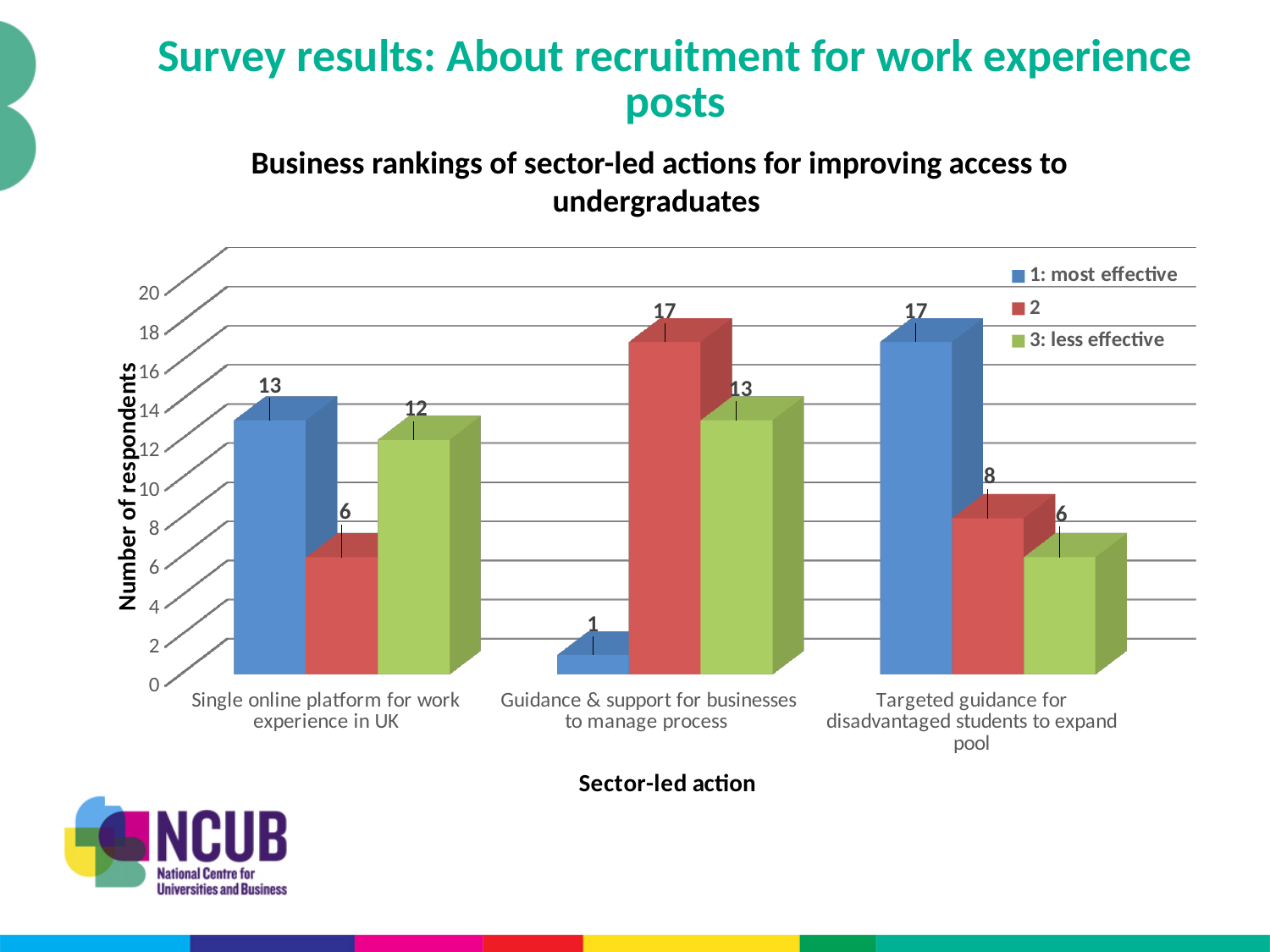
Which sector-led action has the lowest value for '1: most effective'? Guidance & support for businesses to manage process What is the value for '3: less effective' for 'Targeted guidance for disadvantaged students to expand pool'? 6 What is the difference between the '2' value and the '1: most effective' value for 'Guidance & support for businesses to manage process'? 16 What is the title of the chart? Business rankings of sector-led actions for improving access to undergraduates What is the value for '1: most effective' for 'Single online platform for work experience in UK'? 13 How many series does the legend list? 3 For 'Single online platform for work experience in UK', which is larger: the '1: most effective' value or the '3: less effective' value? 1: most effective How many sector-led actions are shown on the x axis? 3 What kind of chart is shown on the slide? Bar chart What is the label of the y axis? Number of respondents What is the value for '2' for 'Guidance & support for businesses to manage process'? 17 Which sector-led action has the highest value for '1: most effective'? Targeted guidance for disadvantaged students to expand pool